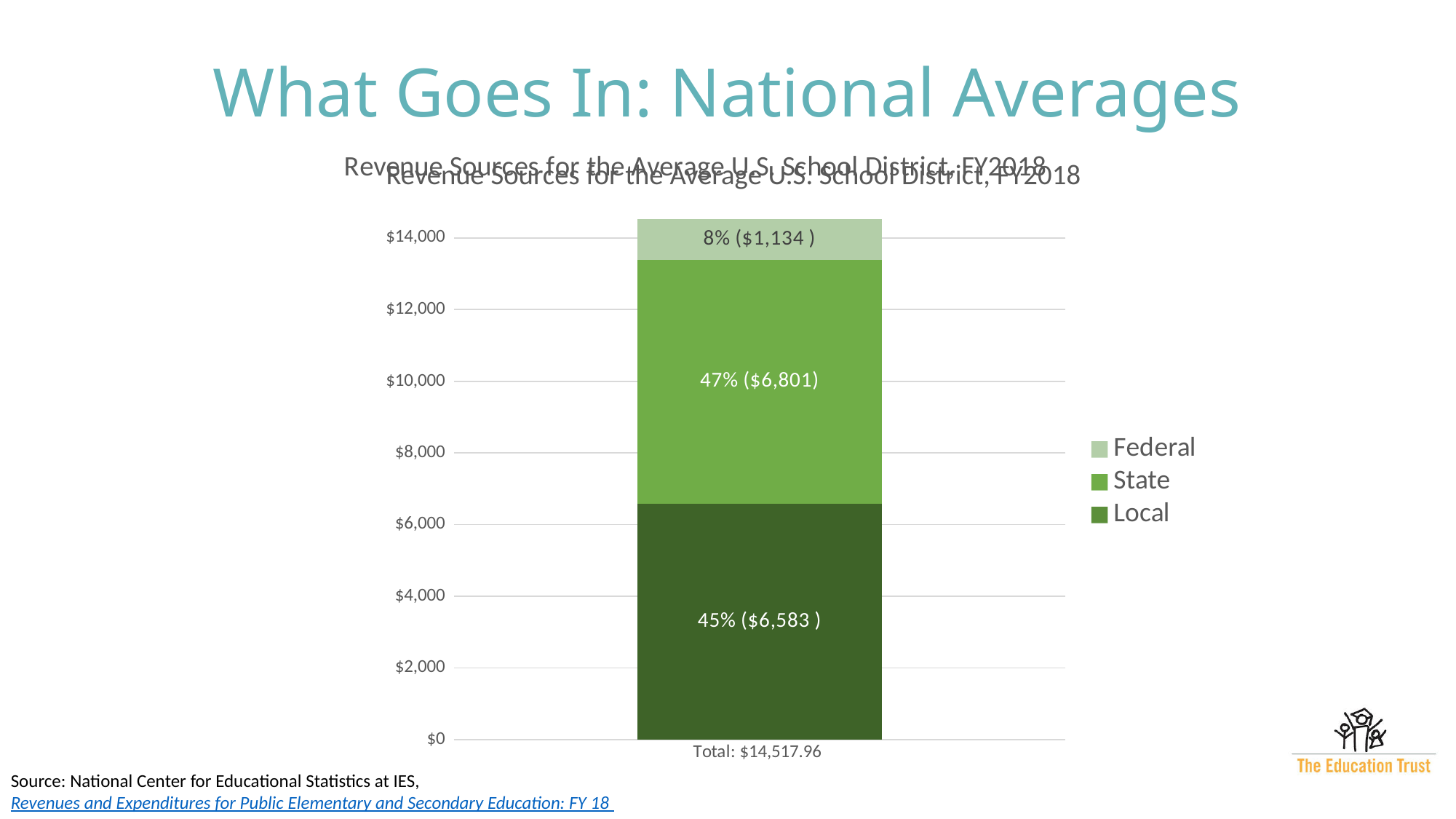
How many series does the legend list? 3 What is the dollar value of the Federal segment in the stacked bar? $1,134 What percentage of revenue comes from State sources according to the chart? 47% Which revenue source has the smallest segment in the stacked bar? Federal Which revenue source has the largest segment in the stacked bar? State Which is larger, the Local segment or the Federal segment? Local What is the dollar value of the State segment in the stacked bar? $6,801 What is the total of the stacked bar as printed on the chart? $14,517.96 What is the dollar value of the Local segment in the stacked bar? $6,583 What kind of chart is shown on the slide? Stacked bar chart What percentage of revenue comes from Federal sources according to the chart? 8% What is the difference in dollars between the State and Local segments? $218